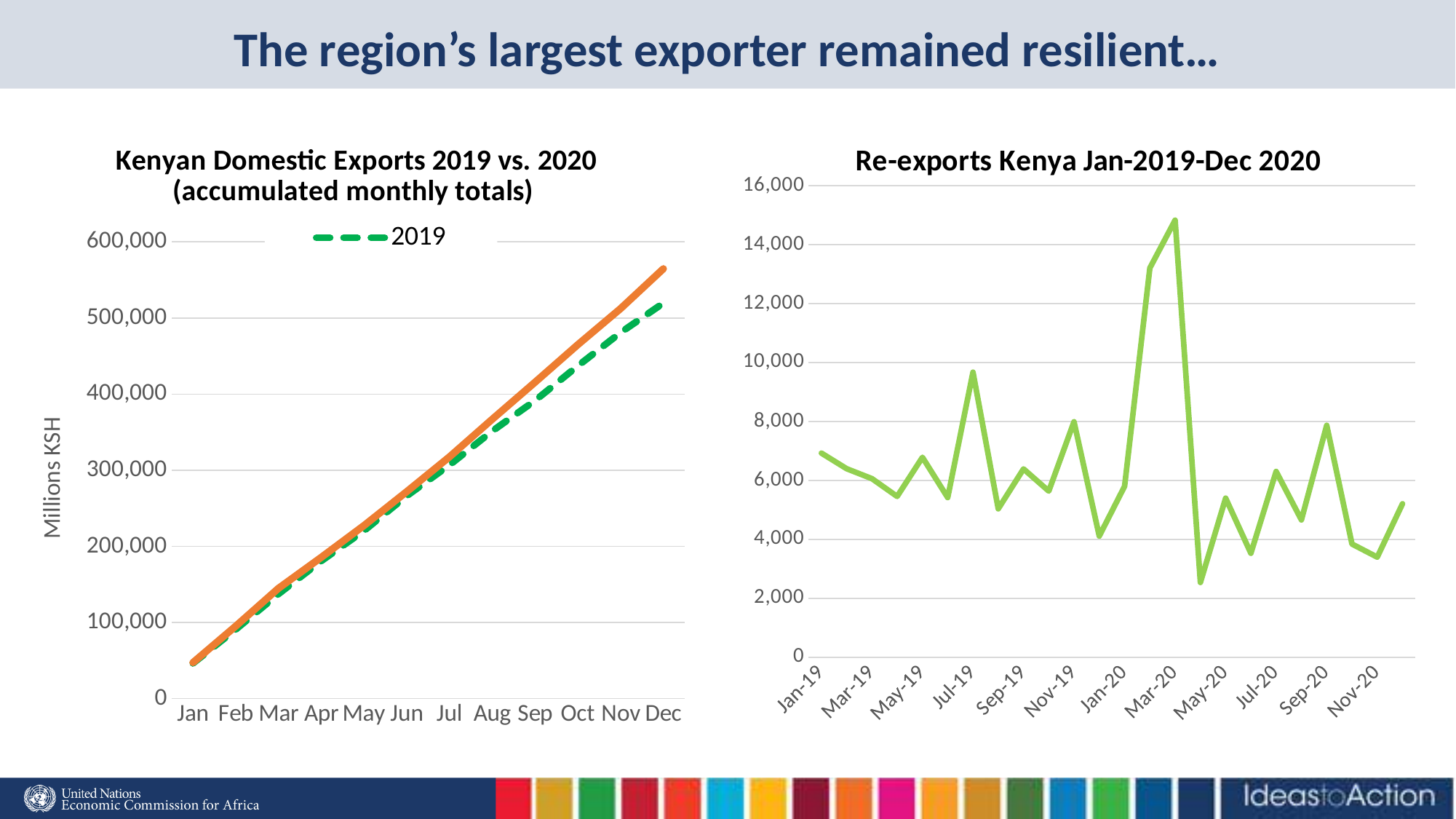
In the left chart, 'Kenyan Domestic Exports 2019 vs. 2020', in Dec is the dashed 2019 line above or below the solid orange line? below What type of chart is the left chart, 'Kenyan Domestic Exports 2019 vs. 2020'? line chart In the right chart, 'Re-exports Kenya Jan-2019-Dec 2020', is the value for Nov-20 greater or less than 4,000? less In the left chart, 'Kenyan Domestic Exports 2019 vs. 2020', how many months are shown on the x axis? 12 What type of chart is the right chart, 'Re-exports Kenya Jan-2019-Dec 2020'? line chart In the left chart, 'Kenyan Domestic Exports 2019 vs. 2020', is the Dec value of the solid orange line greater or less than 500,000? greater What is the y-axis label of the left chart, 'Kenyan Domestic Exports 2019 vs. 2020'? Millions KSH In the right chart, 'Re-exports Kenya Jan-2019-Dec 2020', which is larger, the value for Jul-19 or the value for Mar-20? Mar-20 In the left chart, 'Kenyan Domestic Exports 2019 vs. 2020', do the lines rise or fall from Jan to Dec? rise In the right chart, 'Re-exports Kenya Jan-2019-Dec 2020', which month has the highest value? Mar-20 In the left chart, 'Kenyan Domestic Exports 2019 vs. 2020', is the Jan value of the 2019 line greater or less than 100,000? less